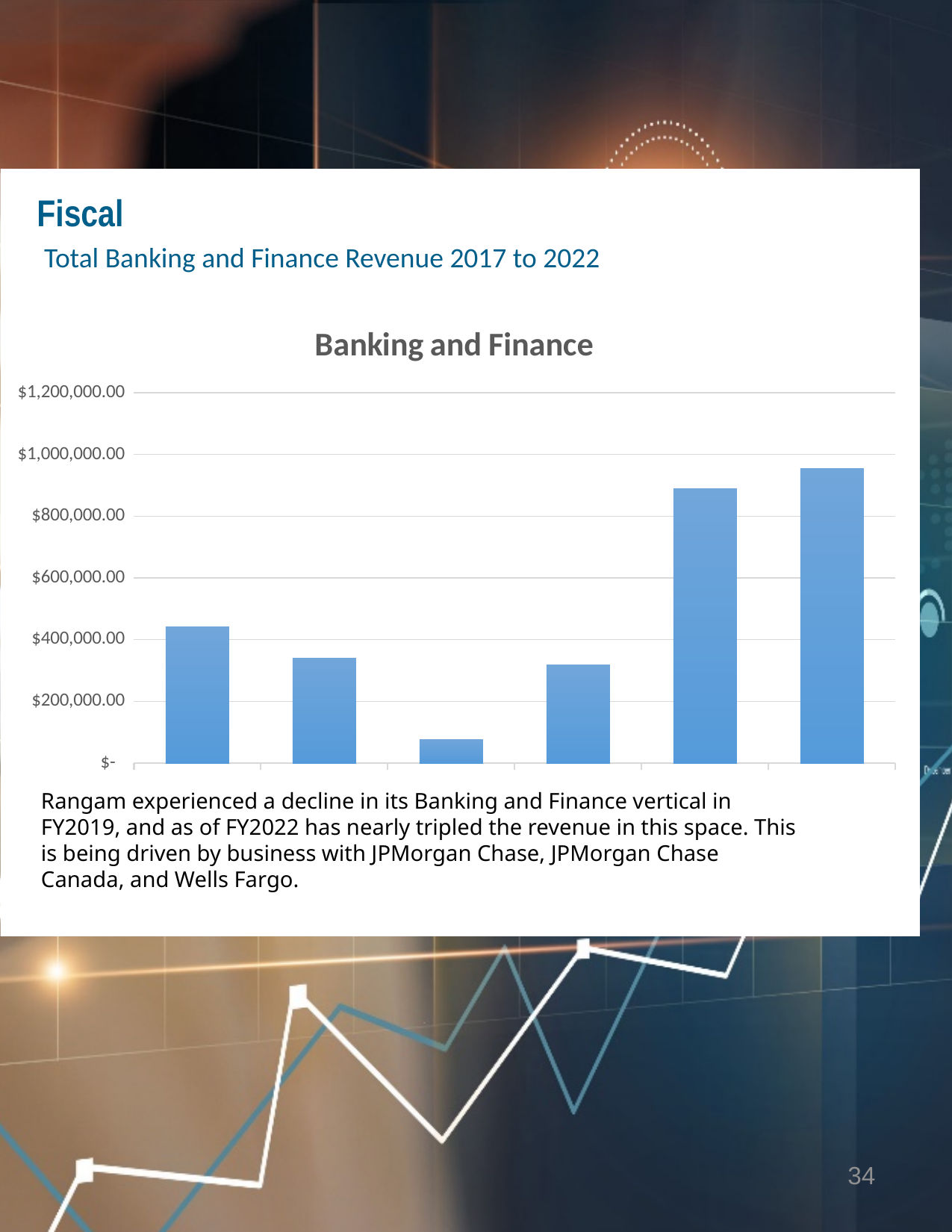
How many bars are plotted in the chart? 6 Which is larger, the first bar or the second bar? the first bar What is the highest value labelled on the vertical axis? $1,200,000.00 Which bar is the shortest in the chart? the third bar Is the value of the first (leftmost) bar greater or less than $400,000.00? greater Do the values rise or fall from the third bar to the sixth bar? rise What kind of chart is shown on the slide? bar chart Is the value of the third bar greater or less than $200,000.00? less Is the value of the sixth (rightmost) bar greater or less than $1,000,000.00? less What is the title of the chart? Banking and Finance Which bar is the tallest in the chart? the sixth (rightmost) bar